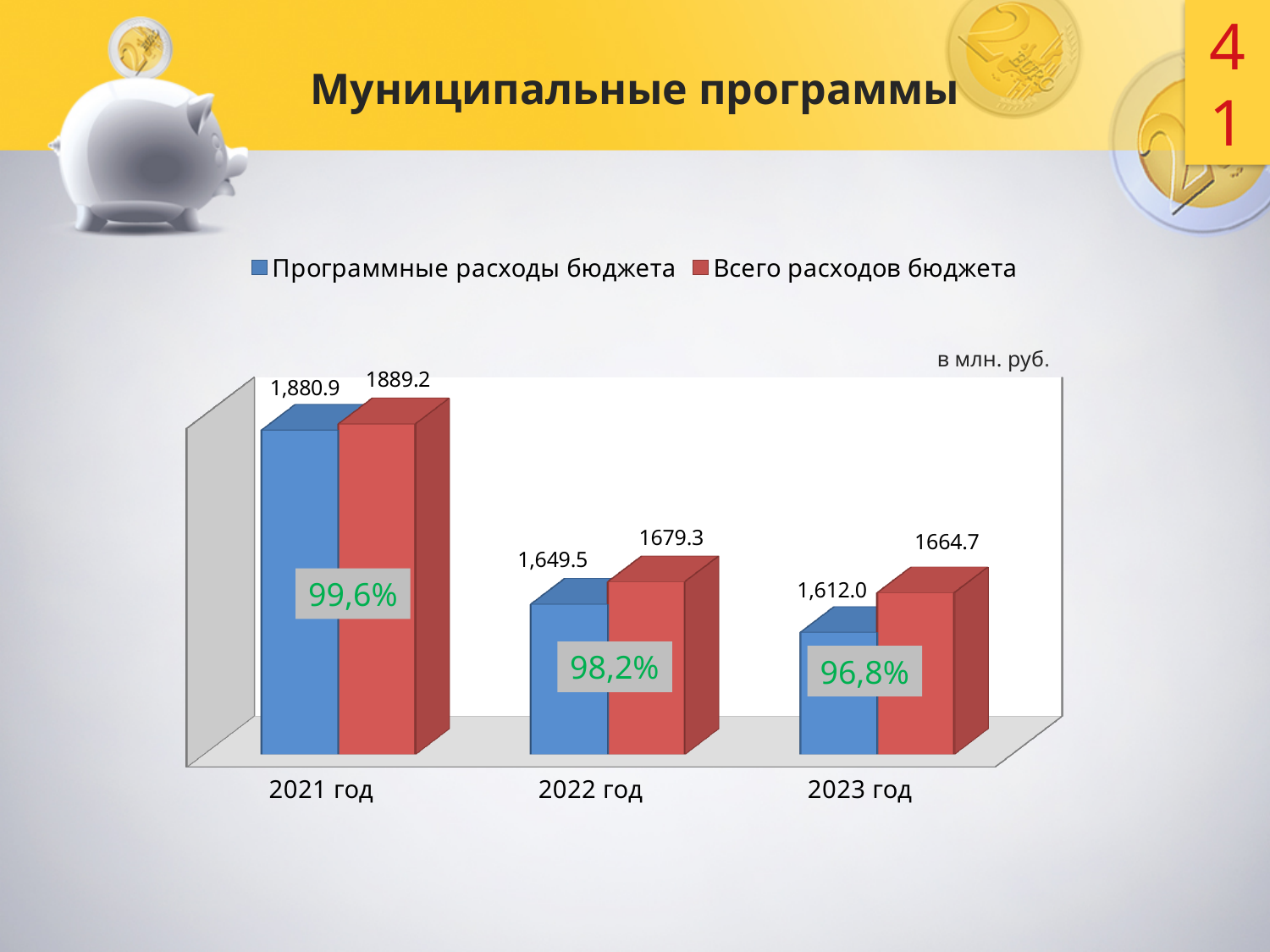
In which year is Программные расходы бюджета the lowest? 2023 год What kind of chart is shown on the slide? Bar chart What percentage label is shown on the bars for 2022 год? 98,2% How many series does the legend list? 2 What is the value for Программные расходы бюджета in 2021 год? 1,880.9 What is the value for Всего расходов бюджета in 2023 год? 1664.7 In which year is Всего расходов бюджета the highest? 2021 год What is the value for Всего расходов бюджета in 2022 год? 1679.3 Which is larger in 2022 год: Программные расходы бюджета or Всего расходов бюджета? Всего расходов бюджета What is the value for Программные расходы бюджета in 2023 год? 1,612.0 Do the values for Программные расходы бюджета rise or fall from 2021 год to 2023 год? Fall What is the difference between Всего расходов бюджета and Программные расходы бюджета in 2023 год? 52.7